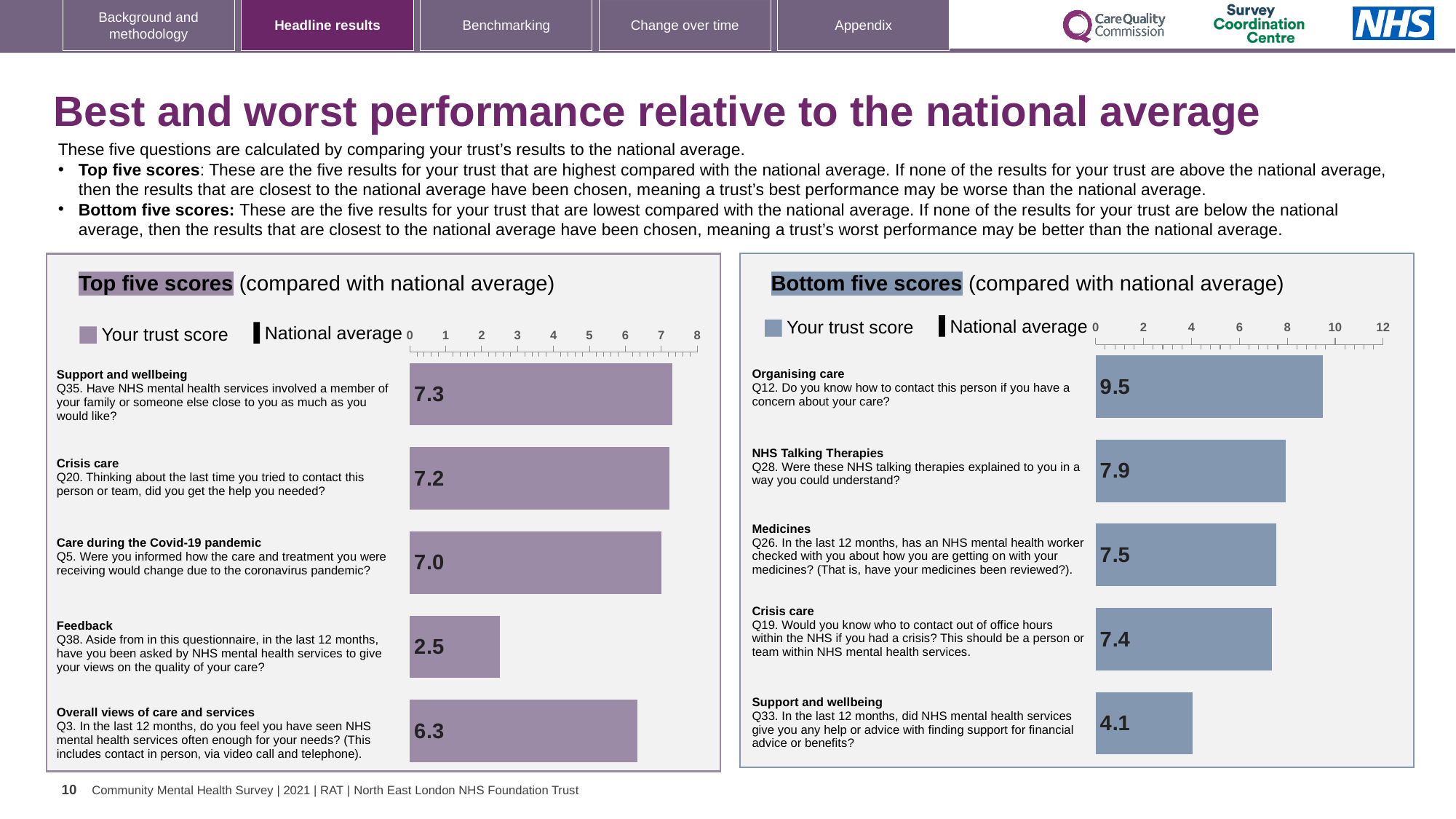
In the Bottom five scores chart, what is the trust score for Q33 (Support and wellbeing)? 4.1 In the Bottom five scores chart, which has the larger trust score, Q26 (Medicines) or Q19 (Crisis care)? Q26 (Medicines) In the Top five scores chart, what is the trust score for Q38 (Feedback)? 2.5 How many questions are shown in the Top five scores chart? 5 In the Top five scores chart, what is the trust score for Q35 (Support and wellbeing)? 7.3 How many series does the legend of the Top five scores chart list? 2 In the Bottom five scores chart, which question has the lowest trust score? Q33 (Support and wellbeing) In the Top five scores chart, which question has the highest trust score? Q35 (Support and wellbeing) In the Bottom five scores chart, what is the difference between the trust scores for Q12 and Q28? 1.6 In the Top five scores chart, what is the difference between the trust scores for Q35 and Q38? 4.8 What type of chart is the Bottom five scores chart? Bar chart In the Bottom five scores chart, what is the trust score for Q12 (Organising care)? 9.5